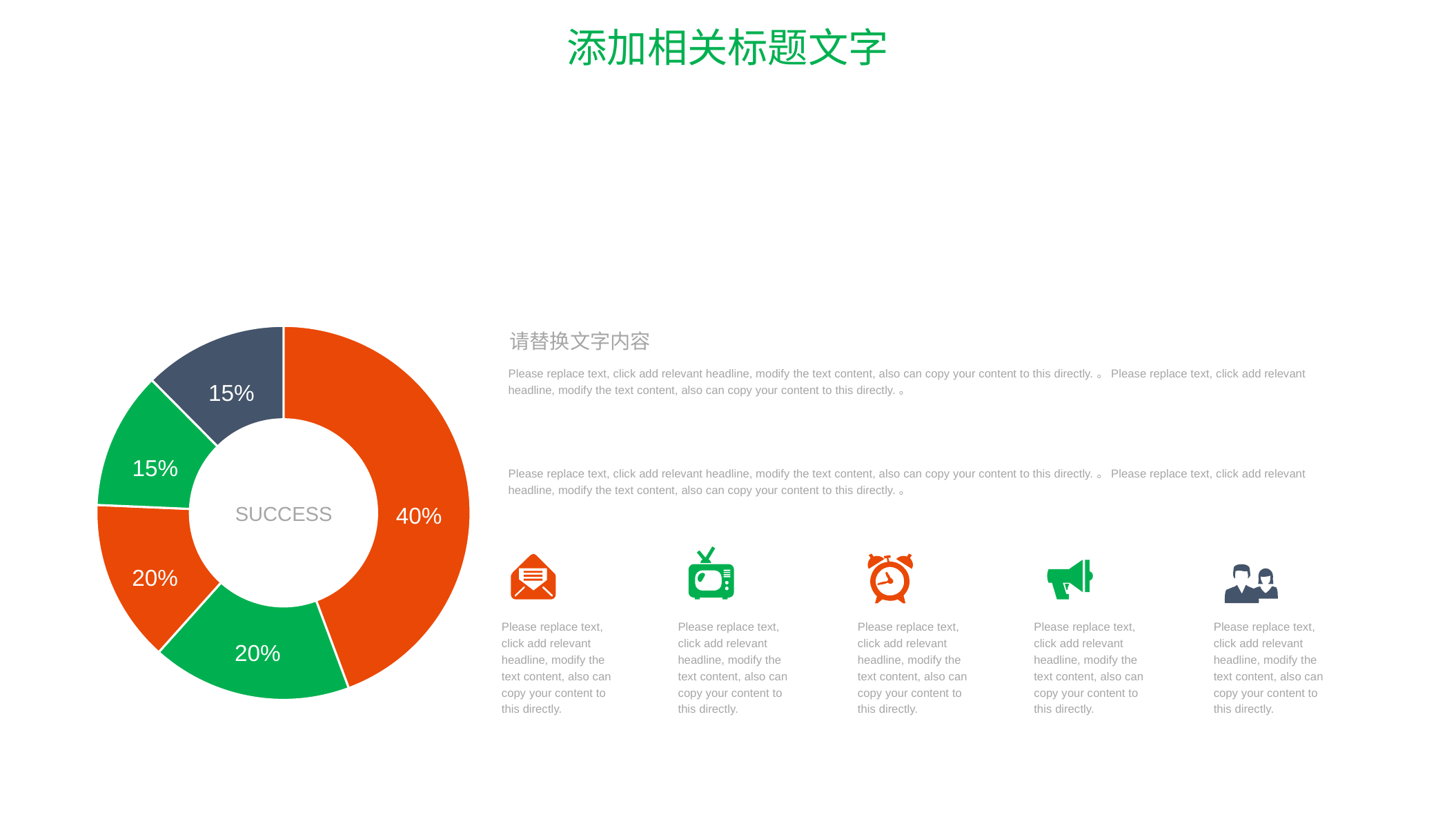
What value is labelled on the large orange slice on the right side of the donut chart? 40% Which is larger: the orange slice on the right or the green slice at the bottom of the donut chart? the orange slice on the right What is the value of the smallest slices in the donut chart? 15% What word is written in the centre of the donut chart? SUCCESS What is the difference between the orange slice on the left (20%) and the dark grey slice at the top (15%)? 5 percentage points How many slices does the donut chart have? 5 What is the difference between the largest slice (40%) and the green slice at the bottom (20%)? 20 percentage points What value is labelled on the dark grey slice at the top of the donut chart? 15% What is the value of the largest slice in the donut chart? 40% What kind of chart is shown on the left of the slide? donut chart How many slices in the donut chart are labelled 15%? 2 What value is labelled on the green slice at the bottom of the donut chart? 20%